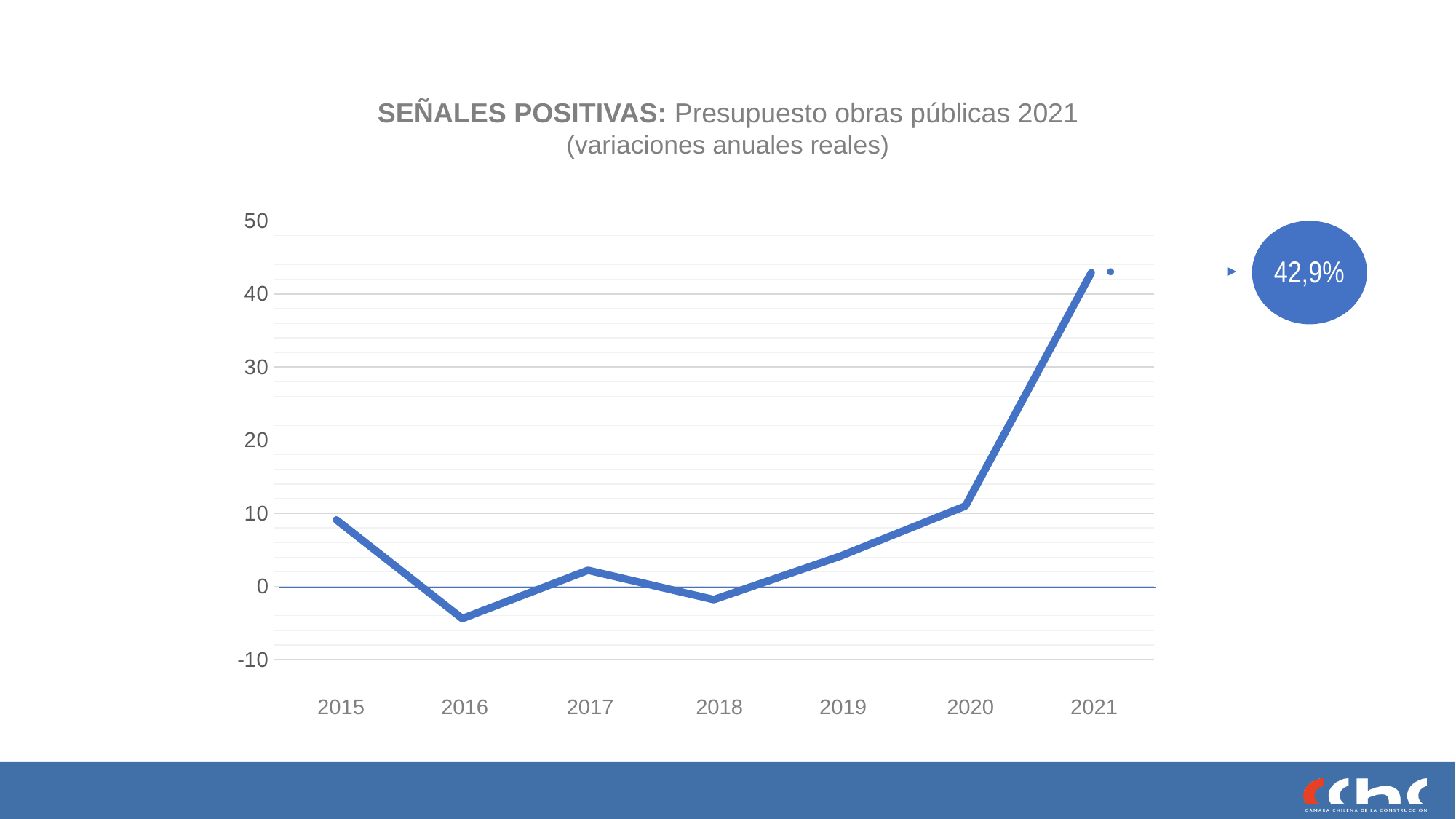
Which year has the lowest value on the chart? 2016 What is the title of the chart? SEÑALES POSITIVAS: Presupuesto obras públicas 2021 (variaciones anuales reales) What value is labelled for 2021 on the chart? 42,9% Which year has the highest value on the chart? 2021 Is the value for 2019 greater or less than 0? greater Which year has the larger value, 2015 or 2016? 2015 How many years are plotted on the x axis? 7 Do the values rise or fall from 2018 to 2021? rise Is the value for 2021 greater or less than 40? greater Which year has the larger value, 2020 or 2021? 2021 Is the value for 2016 greater or less than 0? less What kind of chart is shown on the slide? Line chart